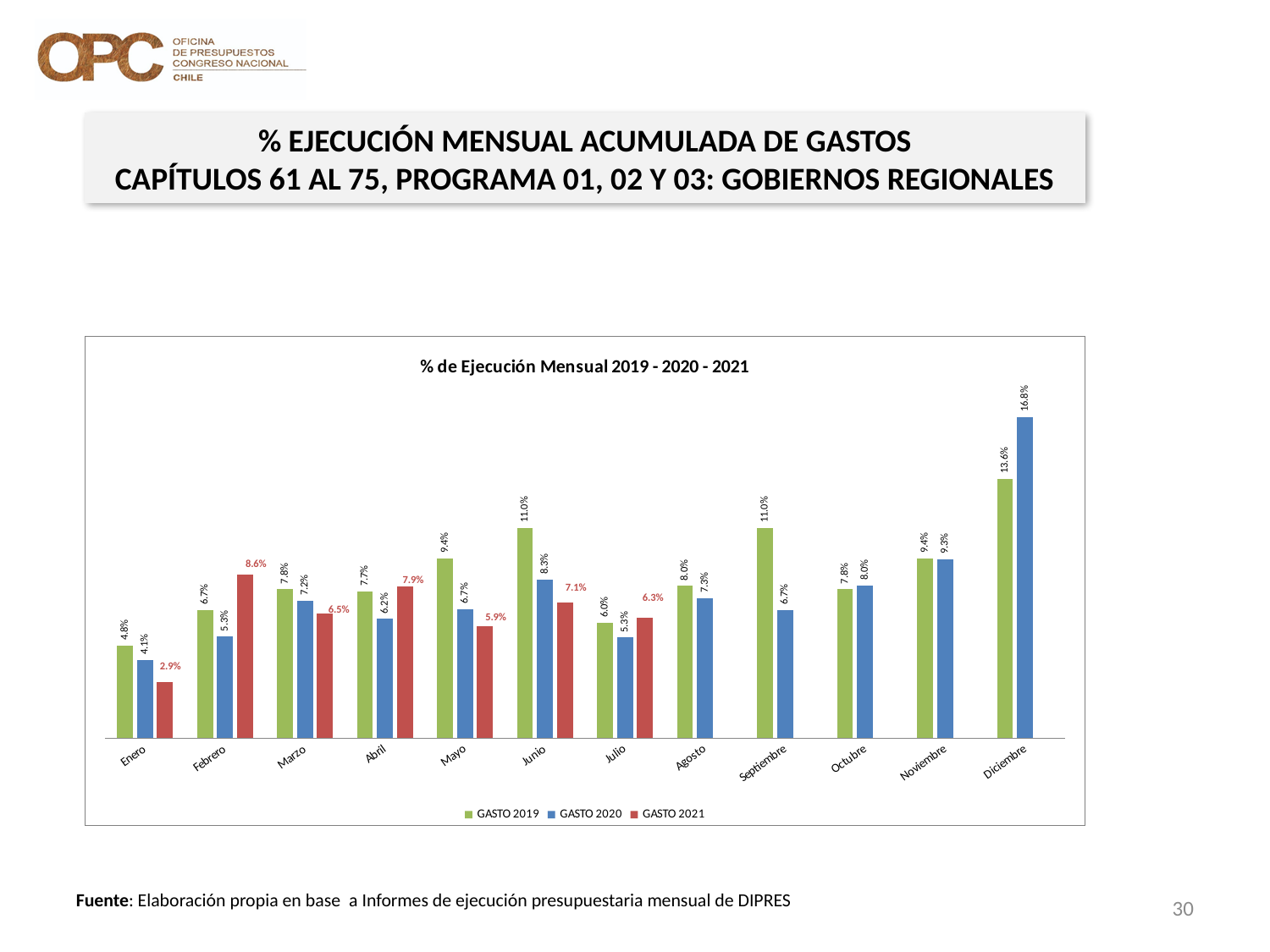
Which month has the highest GASTO 2021 value? Febrero What kind of chart is shown on the slide? Bar chart Which is larger for Mayo, GASTO 2019 or GASTO 2020? GASTO 2019 How many months are shown on the x axis? 12 What is the GASTO 2019 value for Septiembre? 11.0% What is the GASTO 2020 value for Diciembre? 16.8% What is the GASTO 2021 value for Enero? 2.9% Which month has the lowest GASTO 2020 value? Enero Which series is shown in red? GASTO 2021 What is the title of the chart? % de Ejecución Mensual 2019 - 2020 - 2021 What is the difference between the GASTO 2020 and GASTO 2019 values for Diciembre? 3.2% How many series does the legend list? 3